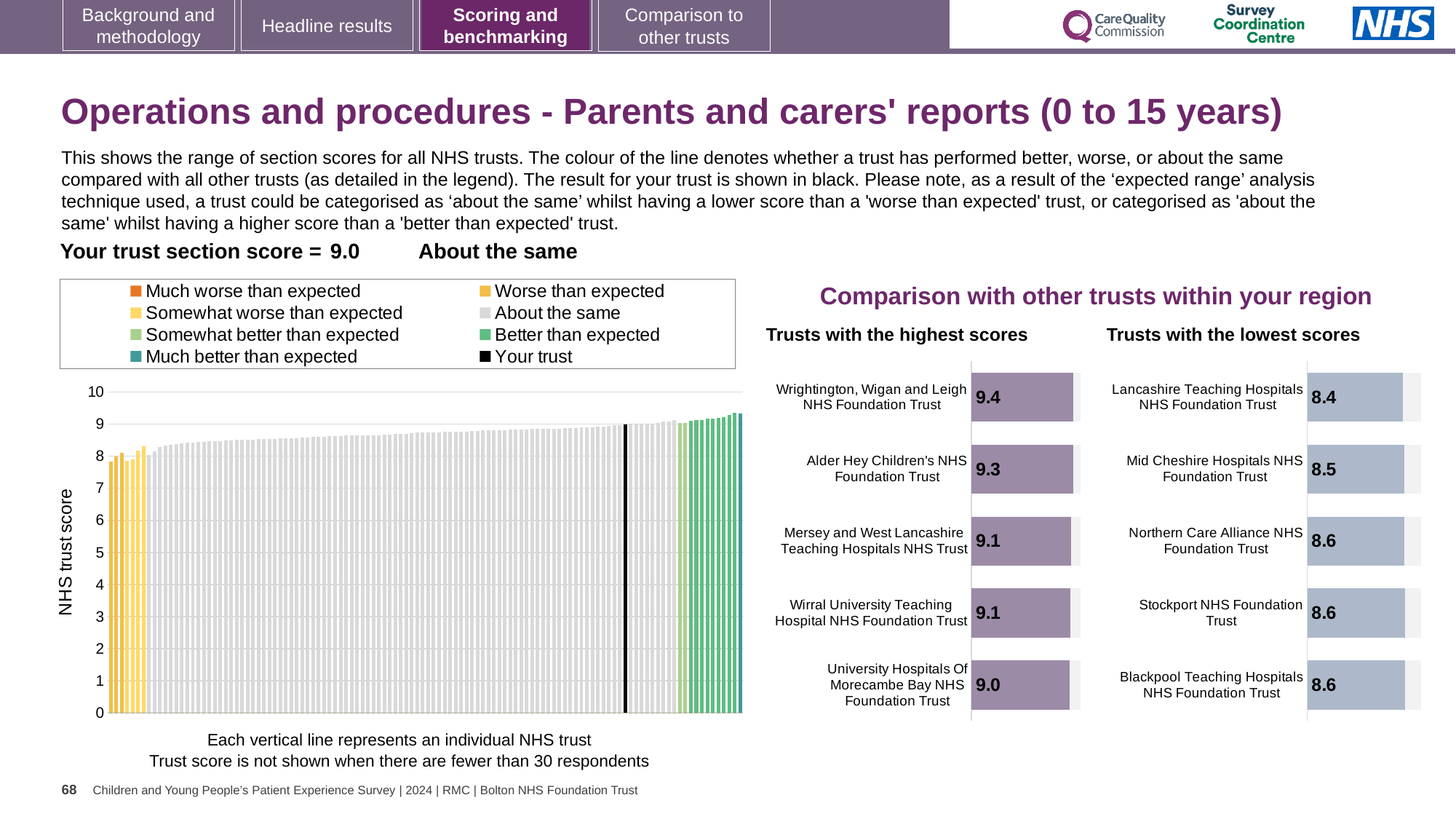
In the 'Trusts with the highest scores' chart, what is the score for Wrightington, Wigan and Leigh NHS Foundation Trust? 9.4 In the 'Trusts with the highest scores' chart, which trust has the lowest score? University Hospitals Of Morecambe Bay NHS Foundation Trust In the main chart on the left showing all NHS trusts, what is the section score for your trust (the black bar)? 9.0 In the 'Trusts with the lowest scores' chart, which trust has the lowest score? Lancashire Teaching Hospitals NHS Foundation Trust How many entries does the legend above the main chart on the left list? 8 How many trusts are listed in the 'Trusts with the lowest scores' chart? 5 In the 'Trusts with the lowest scores' chart, what is the difference between the scores of Blackpool Teaching Hospitals NHS Foundation Trust and Lancashire Teaching Hospitals NHS Foundation Trust? 0.2 In the main chart on the left showing all NHS trusts, is the value of the leftmost (lowest) bar greater or less than 9? less In the main chart on the left showing all NHS trusts, do the bar values rise or fall from left to right? rise In the 'Trusts with the highest scores' chart, what is the difference between the scores of Wrightington, Wigan and Leigh NHS Foundation Trust and University Hospitals Of Morecambe Bay NHS Foundation Trust? 0.4 In the 'Trusts with the highest scores' chart, which has the higher score: Wrightington, Wigan and Leigh NHS Foundation Trust or Alder Hey Children's NHS Foundation Trust? Wrightington, Wigan and Leigh NHS Foundation Trust In the 'Trusts with the lowest scores' chart, what is the score for Mid Cheshire Hospitals NHS Foundation Trust? 8.5